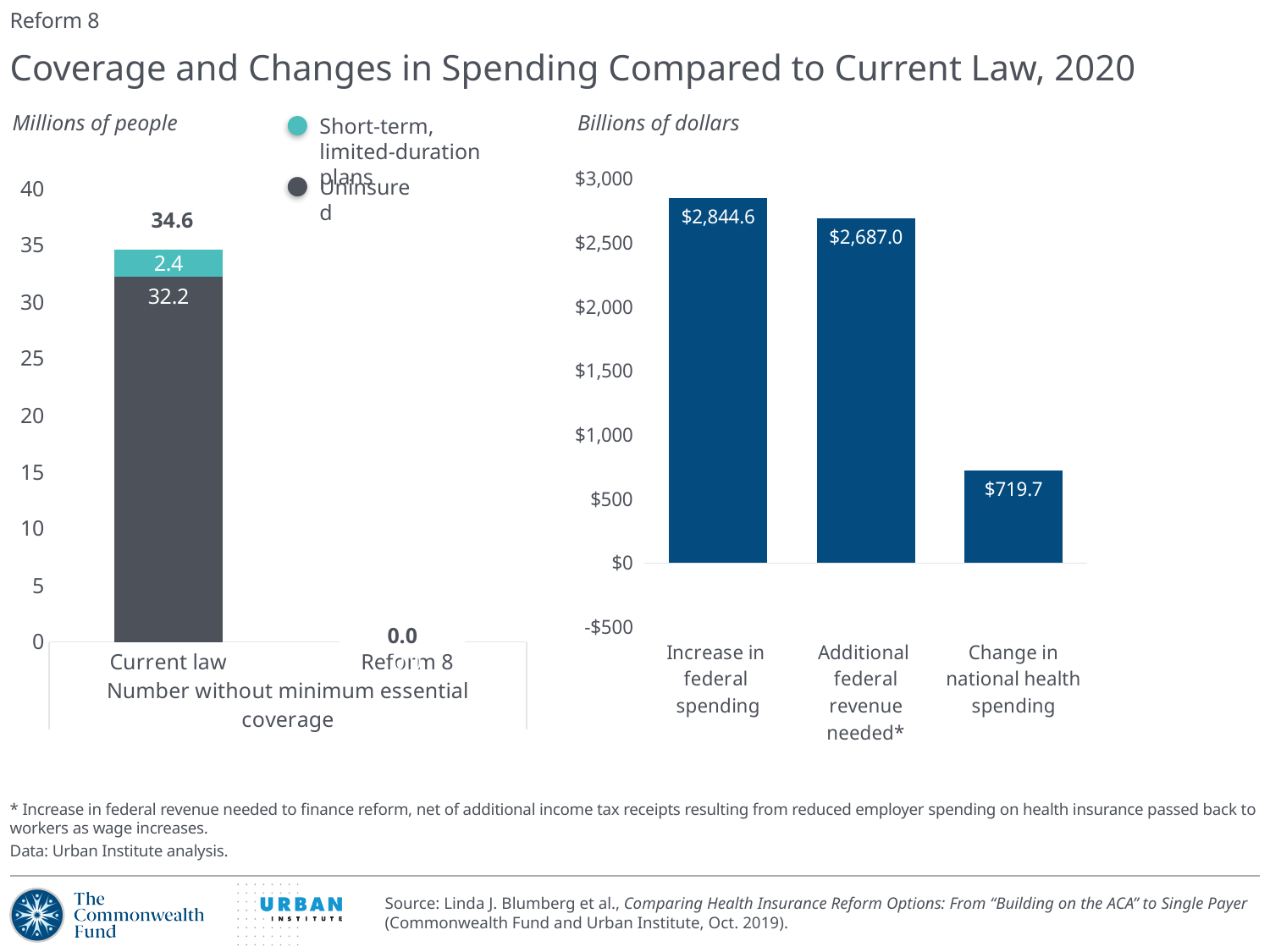
In the right chart (Billions of dollars), what is the value for Increase in federal spending? $2,844.6 In the right chart (Billions of dollars), which category has the lowest value? Change in national health spending In the left chart (Millions of people), what is the difference between the Uninsured value and the Short-term, limited-duration plans value for Current law? 29.8 What kind of chart is the right chart (Billions of dollars)? Bar chart In the right chart (Billions of dollars), what is the value for Additional federal revenue needed? $2,687.0 In the right chart (Billions of dollars), what is the difference between Increase in federal spending and Additional federal revenue needed? $157.6 In the left chart (Millions of people), what is the value shown for Reform 8? 0.0 In the left chart (Millions of people), how many series does the legend list? 2 In the left chart (Millions of people), what is the Short-term, limited-duration plans value for Current law? 2.4 In the left chart (Millions of people), what is the total of the stacked bar for Current law? 34.6 In the right chart (Billions of dollars), how many categories are plotted? 3 In the left chart (Millions of people), what is the Uninsured value for Current law? 32.2